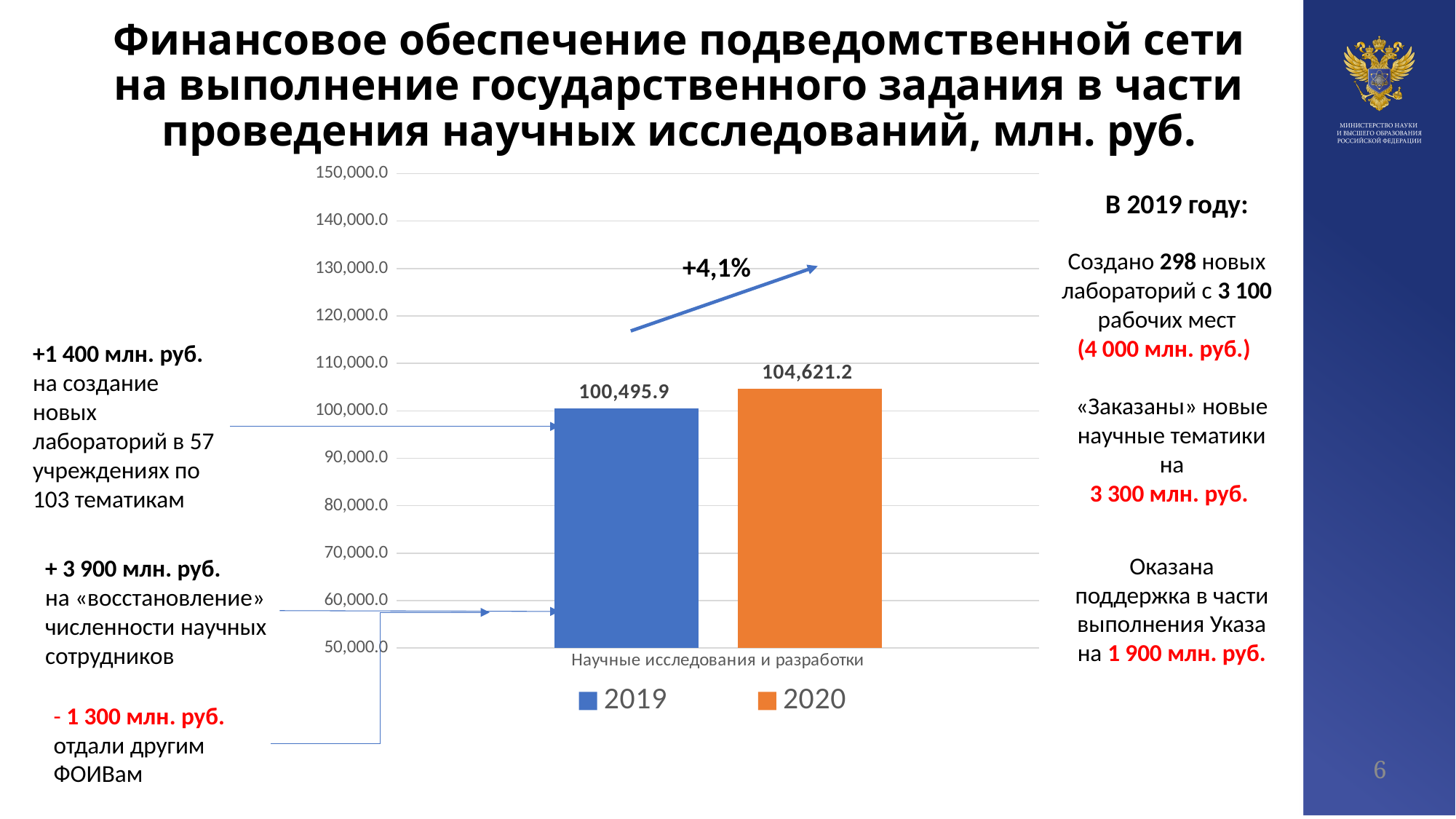
How many categories are shown on the x axis of the chart? 1 What kind of chart is shown on the slide? bar chart What percentage change is annotated above the bars in the chart? +4,1% What is the category label on the x axis of the chart? Научные исследования и разработки Which series has the higher value, 2019 or 2020? 2020 What is the value for 2020 in the chart? 104,621.2 How many series does the legend list? 2 Is the value for 2019 greater or less than 110,000.0? less What is the difference between the 2020 and 2019 values? 4,125.3 Is the value for 2020 greater or less than 100,000.0? greater What is the value for 2019 in the chart? 100,495.9 Which series is shown in orange in the chart? 2020